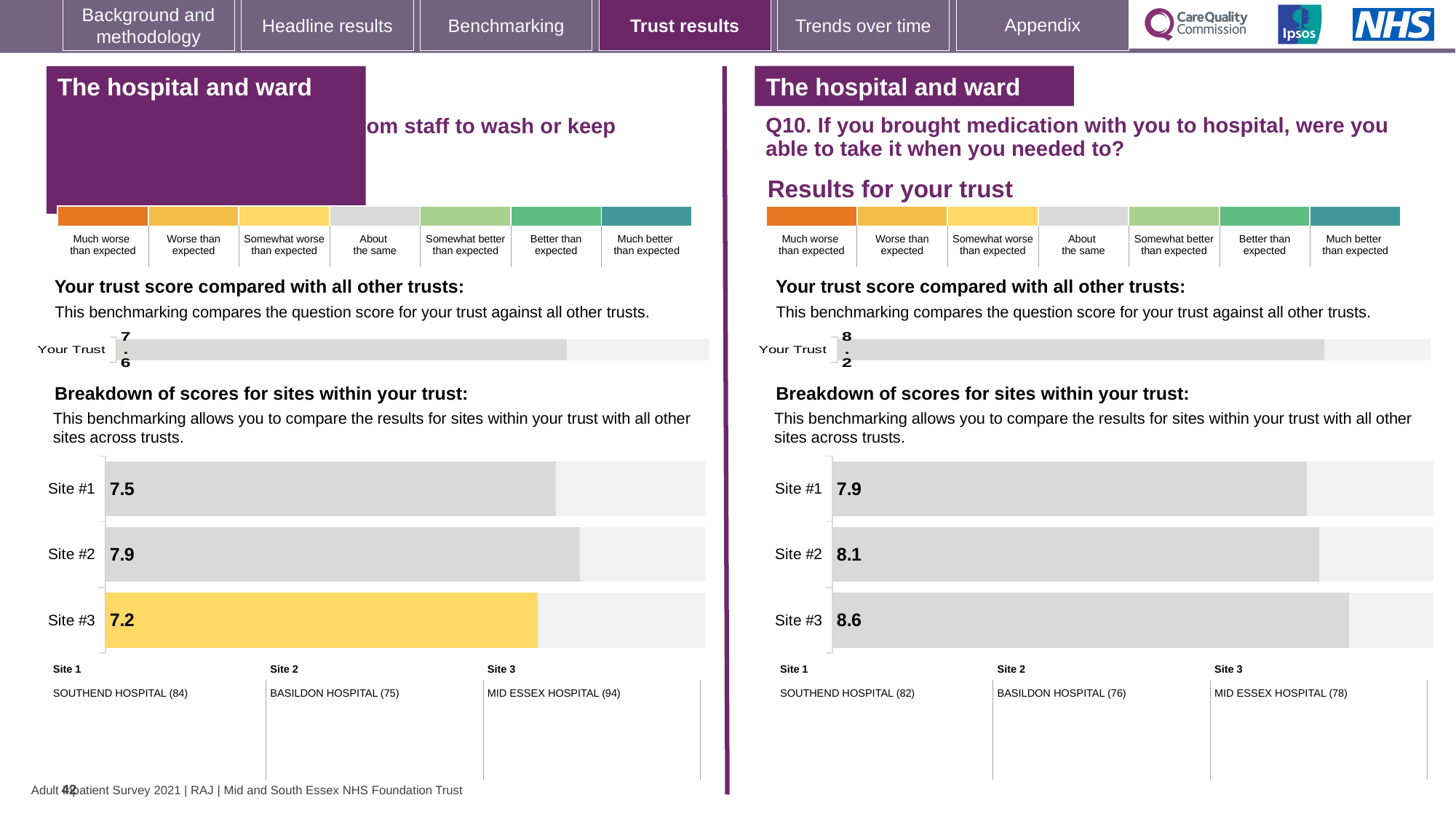
On the left-hand site breakdown chart, what is the difference between the scores for Site #2 and Site #3? 0.7 On the right-hand site breakdown chart, what is the difference between the scores for Site #3 and Site #1? 0.7 On the right-hand site breakdown chart, which site has the highest score? Site #3 On the left-hand site breakdown chart, what is the score for Site #1? 7.5 On the left-hand site breakdown chart, which site's bar is coloured yellow rather than grey? Site #3 On the right-hand chart (Q10, medication), what is the score for Site #3? 8.6 What type of chart is used for the site breakdown on the right-hand side of the slide? Bar chart On the right-hand 'Your trust score compared with all other trusts' chart, what is the score for Your Trust? 8.2 On the left-hand 'Your trust score compared with all other trusts' chart, what is the score for Your Trust? 7.6 How many sites are shown in the left-hand site breakdown chart? 3 On the right-hand site breakdown chart, which has the larger score, Site #1 or Site #2? Site #2 On the left-hand site breakdown chart, which site has the lowest score? Site #3